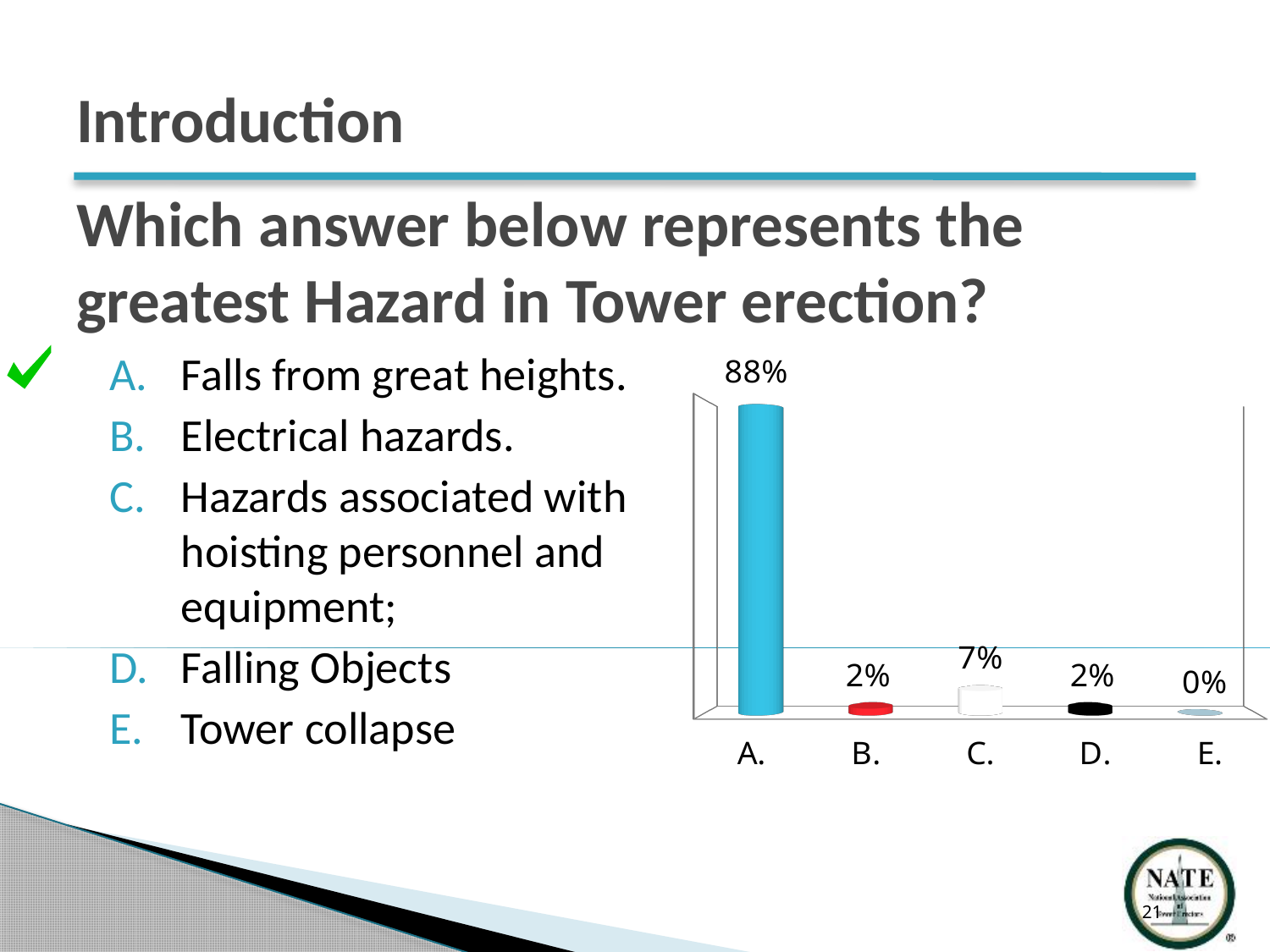
What is the difference between the values for A. and C. in the chart? 81% What is the value for category A. in the chart? 88% Which category has the lowest value in the chart? E. What kind of chart is shown on the slide? Bar chart What colour is the bar for category A. in the chart? Blue Which is larger in the chart, the value for C. or the value for D.? C. What is the value for category B. in the chart? 2% What is the difference between the values for C. and D. in the chart? 5% Which category has the highest value in the chart? A. What is the value for category C. in the chart? 7% How many categories are shown on the x axis of the chart? 5 What is the value for category E. in the chart? 0%